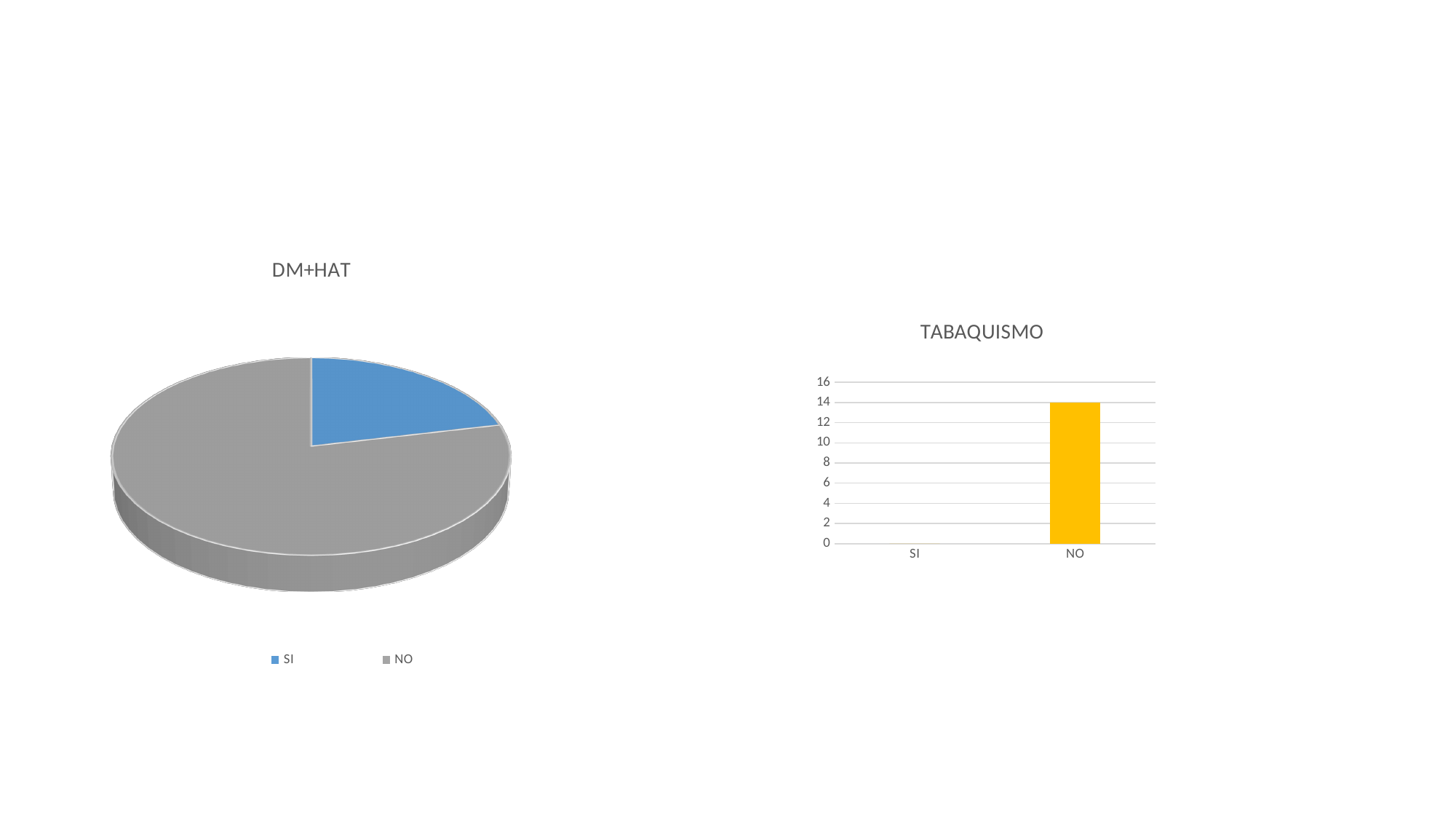
What kind of chart is the DM+HAT chart? pie chart What kind of chart is the TABAQUISMO chart? bar chart In the TABAQUISMO chart, what is the difference between the values for NO and SI? 14 In the TABAQUISMO chart, is the value for NO greater or less than 10? greater In the TABAQUISMO chart, what is the value for SI? 0 In the TABAQUISMO chart, what is the value for NO? 14 In the DM+HAT pie chart, which slice is larger, SI or NO? NO In the TABAQUISMO chart, which category has the highest value? NO How many categories are shown on the x axis of the TABAQUISMO chart? 2 In the DM+HAT chart, what colour is the SI slice? blue How many entries does the legend of the DM+HAT chart list? 2 In the TABAQUISMO chart, which category has the lowest value? SI